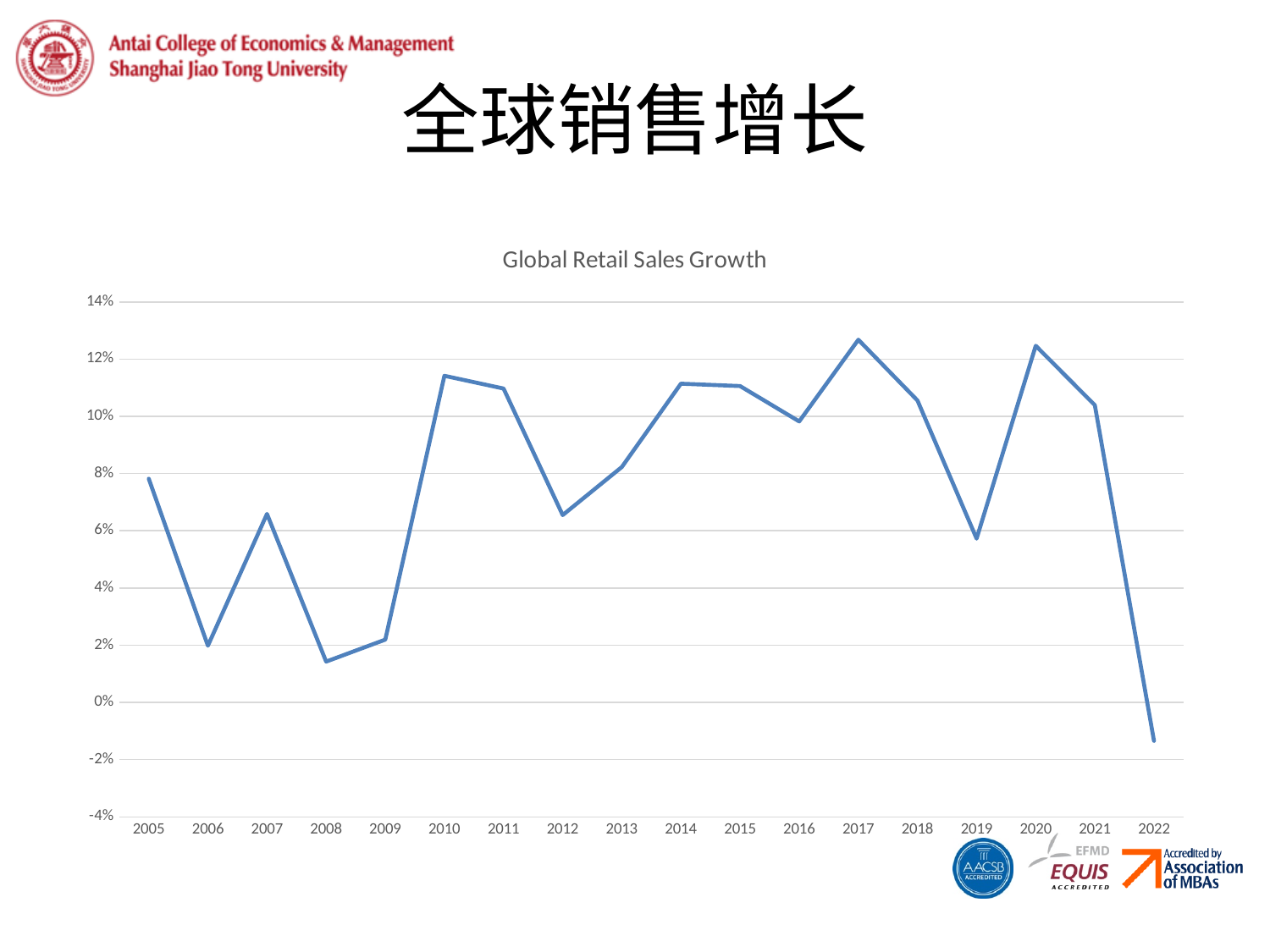
Does the value rise or fall from 2020 to 2022? fall Is the value for 2017 greater or less than 12%? greater Which year has the higher value, 2005 or 2006? 2005 Is the value for 2008 greater or less than 2%? less Is the value for 2022 greater or less than 0%? less What kind of chart is shown on the slide? line chart How many years are plotted on the x axis of the chart? 18 What is the title of the chart? Global Retail Sales Growth Which year has the higher value, 2012 or 2013? 2013 Which year has the lowest global retail sales growth? 2022